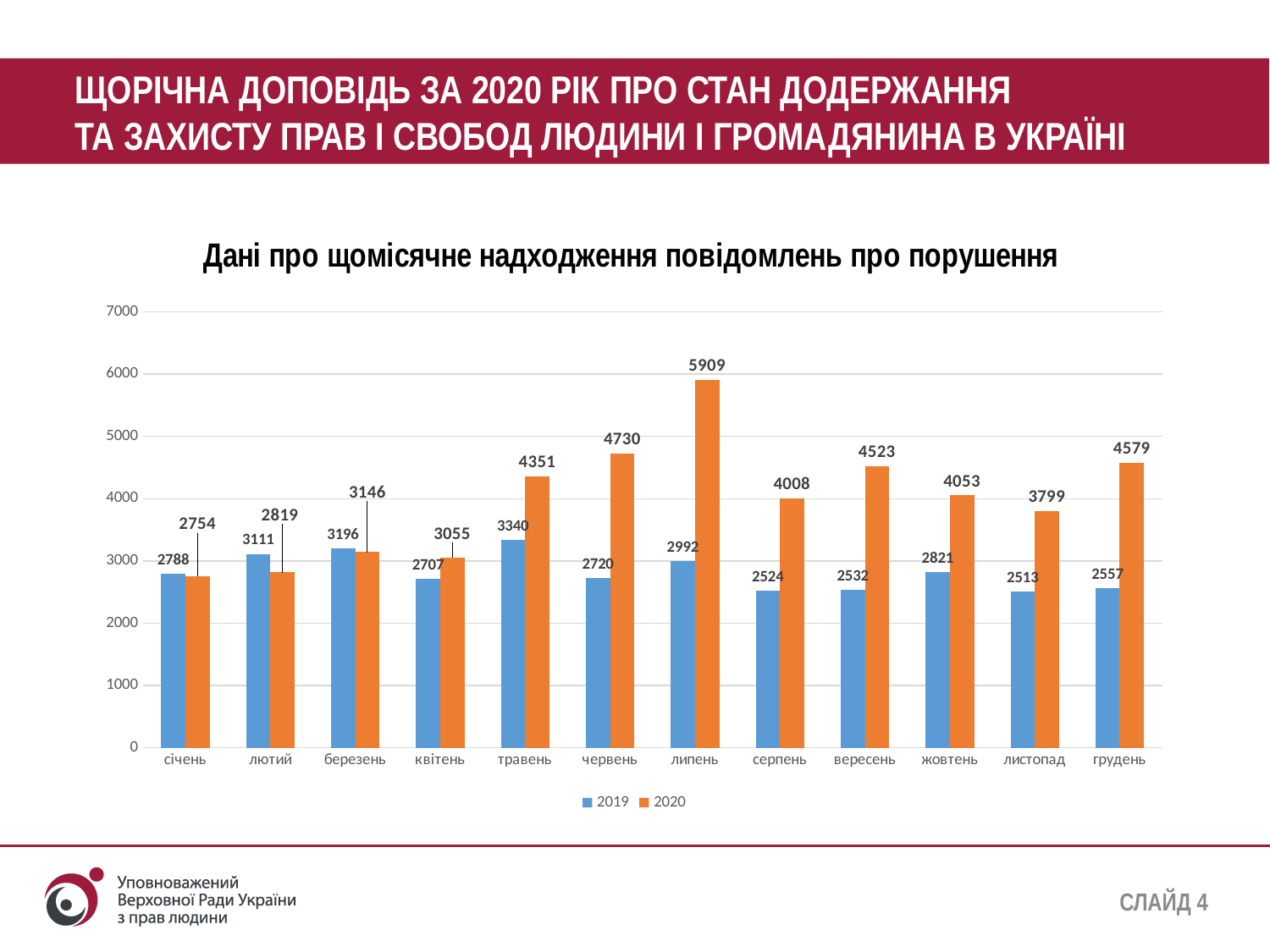
What is the value for 2020 in липень? 5909 Is the value for 2020 in червень greater or less than 4000? greater How many series does the legend list? 2 How many months are shown on the x axis? 12 Which month has the lowest value for the 2019 series? листопад What kind of chart is shown on the slide? bar chart What is the value for 2019 in травень? 3340 Which month has the highest value for the 2020 series? липень Which is larger in лютий: the 2019 value or the 2020 value? 2019 What colour are the bars for the 2020 series? orange What is the title of the chart? Дані про щомісячне надходження повідомлень про порушення What is the difference between the 2020 and 2019 values in липень? 2917